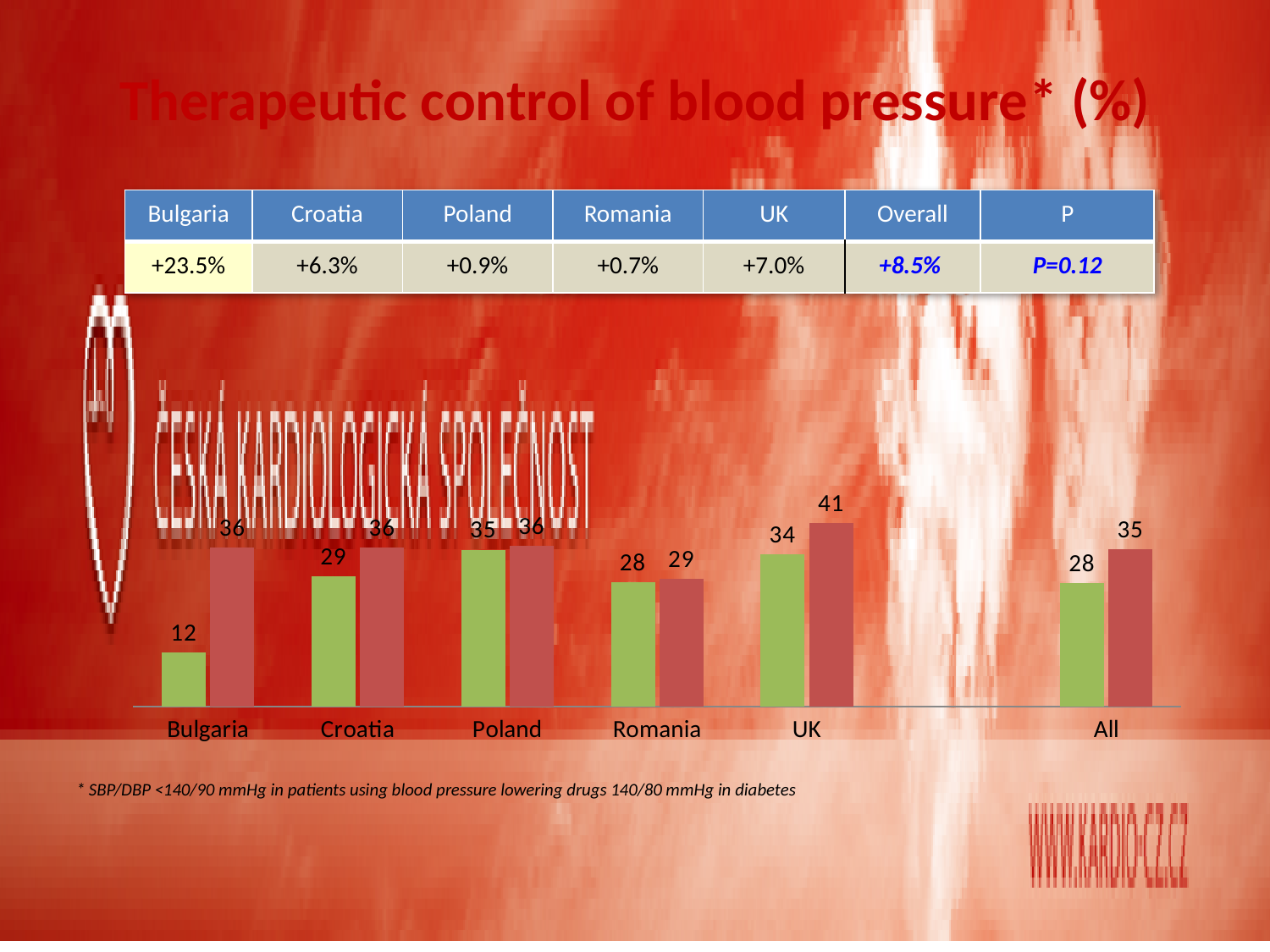
How many categories are shown on the x axis of the chart? 6 What is the value of the green bar for Bulgaria? 12 Which is larger for Croatia, the green bar or the red bar? the red bar What is the difference between the red bar and the green bar for Bulgaria? 24 What is the difference between the red bar and the green bar for UK? 7 What is the value of the green bar for Poland? 35 What is the value of the red bar for UK? 41 Which category has the lowest green bar? Bulgaria What is the title of the slide containing the chart? Therapeutic control of blood pressure* (%) Which category has the highest red bar? UK What is the value of the red bar for All? 35 What type of chart is shown on the slide? bar chart